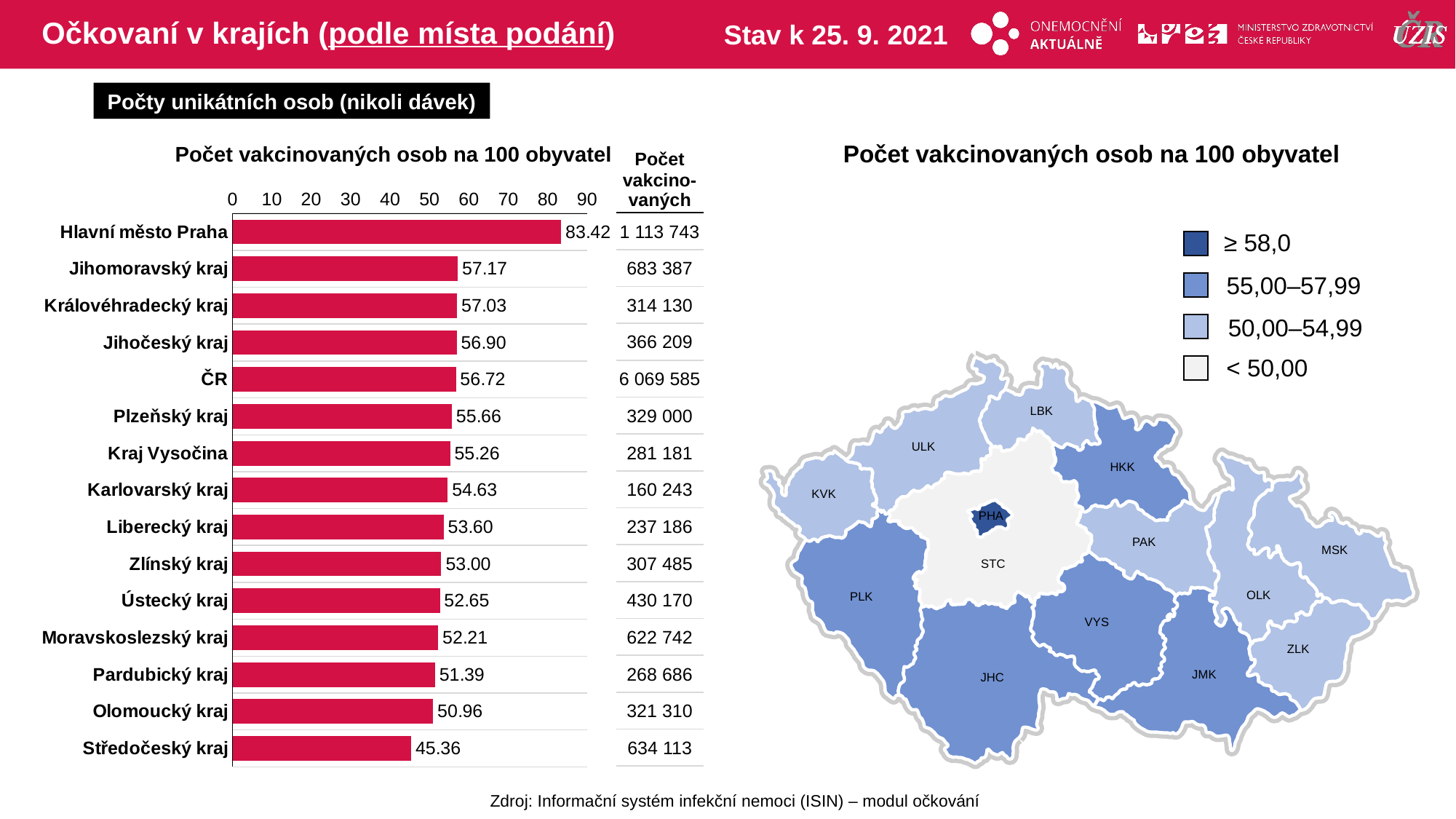
In the bar chart, which region has the highest number of vaccinated persons per 100 inhabitants? Hlavní město Praha In the bar chart, what is the value for Kraj Vysočina? 55.26 In the bar chart, which region has the lowest number of vaccinated persons per 100 inhabitants? Středočeský kraj In the bar chart, what is the value for Hlavní město Praha? 83.42 In the bar chart, what is the value for ČR? 56.72 In the bar chart, is the value for Středočeský kraj greater or less than 50? less How many value ranges does the legend of the map on the right list? 4 In the bar chart, what is the difference between the values for Hlavní město Praha and Středočeský kraj? 38.06 In the bar chart, what is the difference between the values for Jihomoravský kraj and Královéhradecký kraj? 0.14 What kind of chart is shown on the left of the slide? bar chart In the bar chart, which is larger: the value for Plzeňský kraj or for Kraj Vysočina? Plzeňský kraj How many categories (bars) are shown in the bar chart? 15